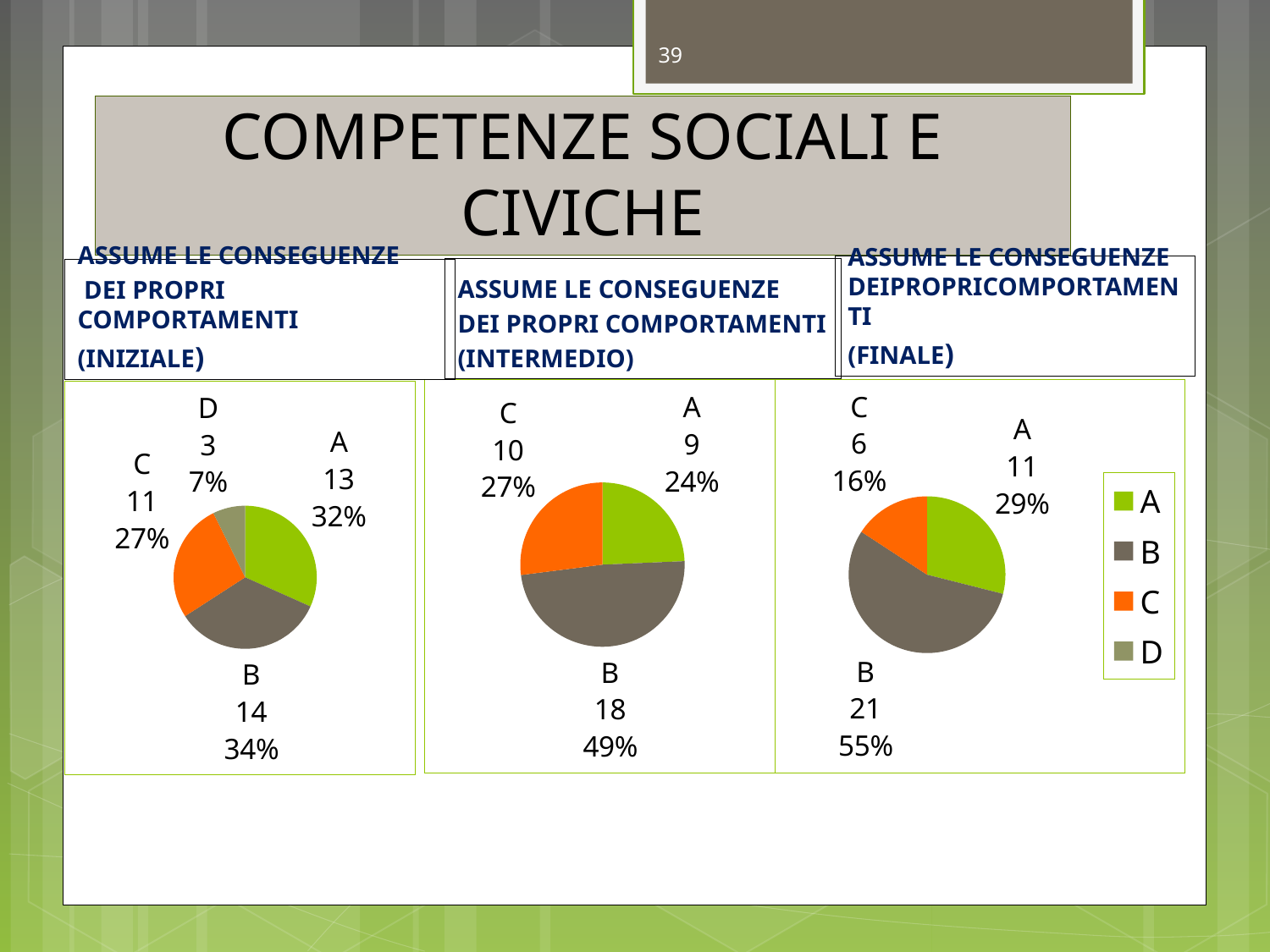
In the INTERMEDIO pie chart, what is the value for category B? 18 In the FINALE pie chart, which category has the largest slice? B In the INIZIALE pie chart, what is the value for category B? 14 In the INIZIALE pie chart, what percentage does category D represent? 7% In the INTERMEDIO pie chart, what is the difference between the values for B and A? 9 How many categories are shown in the INIZIALE pie chart? 4 What type of chart is used on this slide? Pie chart In the INTERMEDIO pie chart, what percentage does category A represent? 24% In the FINALE pie chart, which is larger, the value for A or the value for C? A In the FINALE pie chart, what percentage does category B represent? 55% In the INIZIALE pie chart, which category has the smallest slice? D In the FINALE pie chart, what is the value for category C? 6